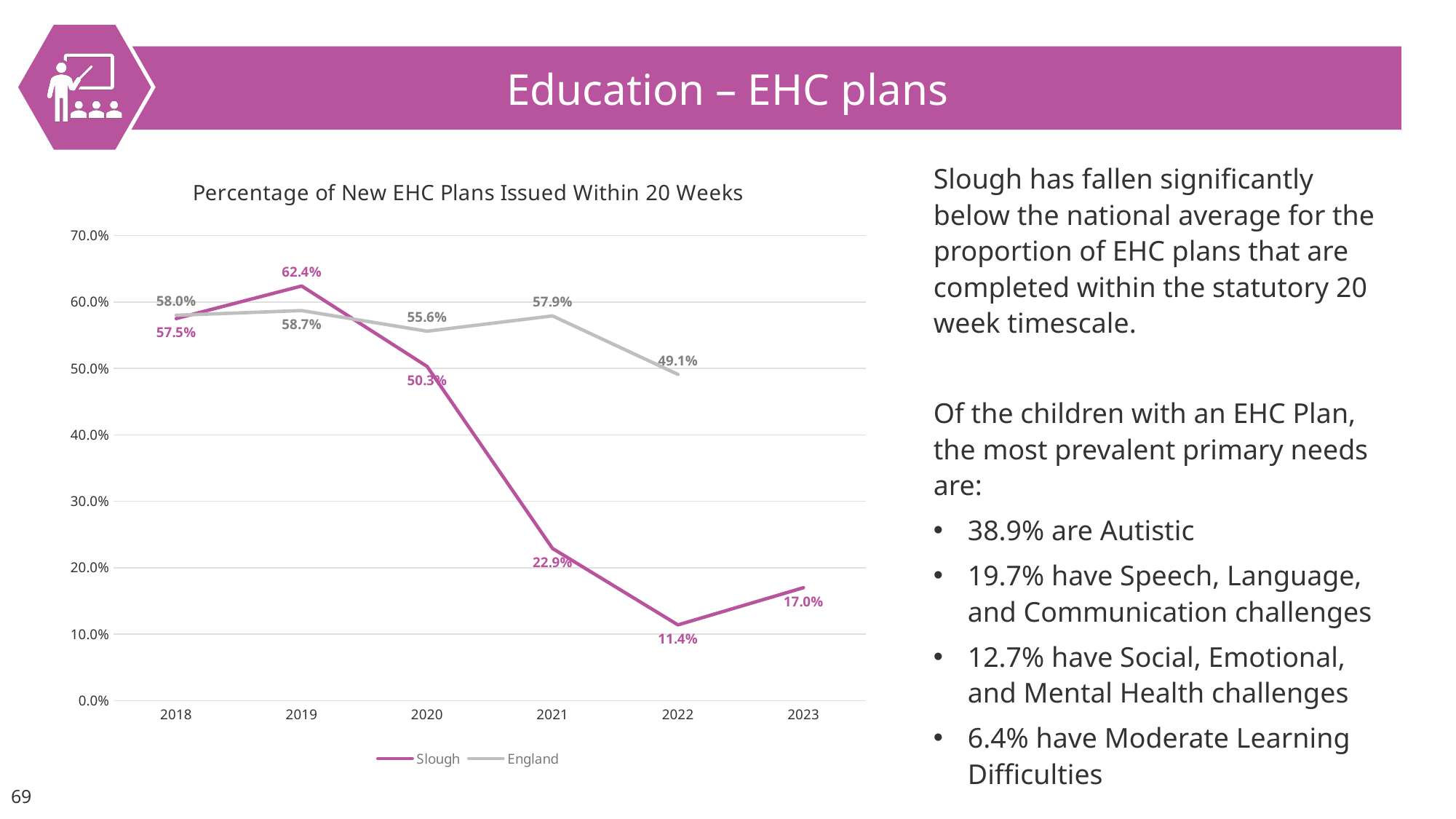
What was the Slough value in 2019? 62.4% What is the title of the chart? Percentage of New EHC Plans Issued Within 20 Weeks What was the England value in 2022? 49.1% What is the difference between the England and Slough values in 2021? 35.0% How many series does the chart legend list? 2 What was the Slough value in 2022? 11.4% In which year was the Slough value lowest? 2022 In which year was the Slough value highest? 2019 How many years are shown on the x axis? 6 Which series had the higher value in 2020, Slough or England? England Did the Slough value rise or fall between 2019 and 2022? Fall What type of chart is shown on the slide? Line chart